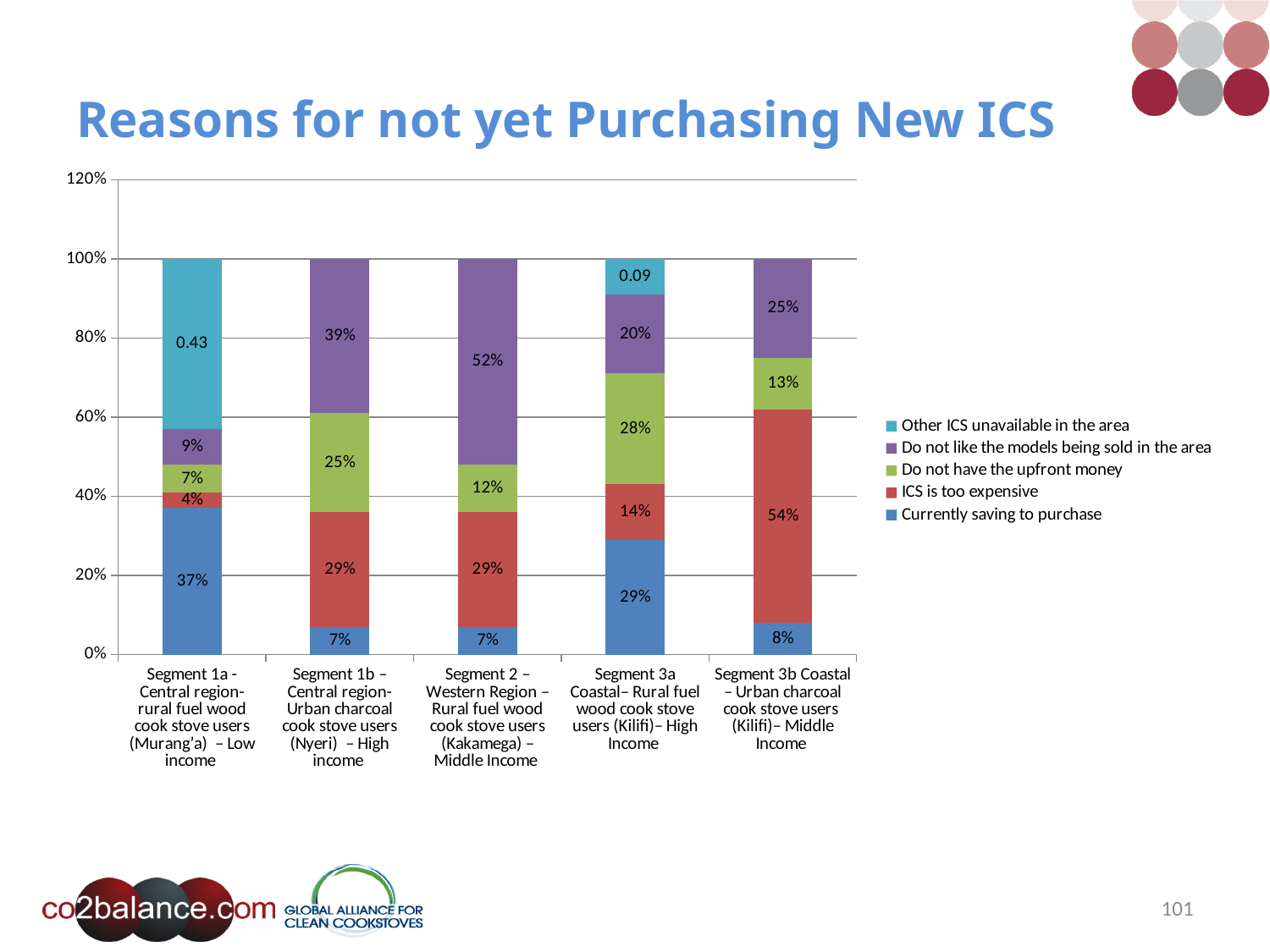
How many series does the legend list? 5 Which segment has the lowest value for 'ICS is too expensive'? Segment 1a - Central region- rural fuel wood cook stove users (Murang'a) – Low income What is the value for 'ICS is too expensive' in Segment 3b (Kilifi, Middle Income)? 54% How many segments (categories) are shown on the x axis? 5 What label is printed on the 'Other ICS unavailable in the area' portion of the Segment 1a bar? 0.43 What is the value for 'Currently saving to purchase' in Segment 1a (Murang'a, Low income)? 37% What is the value for 'Do not like the models being sold in the area' in Segment 2 (Kakamega, Middle Income)? 52% What is the title of the chart? Reasons for not yet Purchasing New ICS What is the difference between 'ICS is too expensive' in Segment 3b (54%) and in Segment 3a (14%)? 40% Which segment has the highest value for 'Do not have the upfront money'? Segment 3a Coastal – Rural fuel wood cook stove users (Kilifi) – High Income Which is larger: 'Currently saving to purchase' in Segment 3a or in Segment 3b? Segment 3a What kind of chart is shown on the slide? stacked bar chart